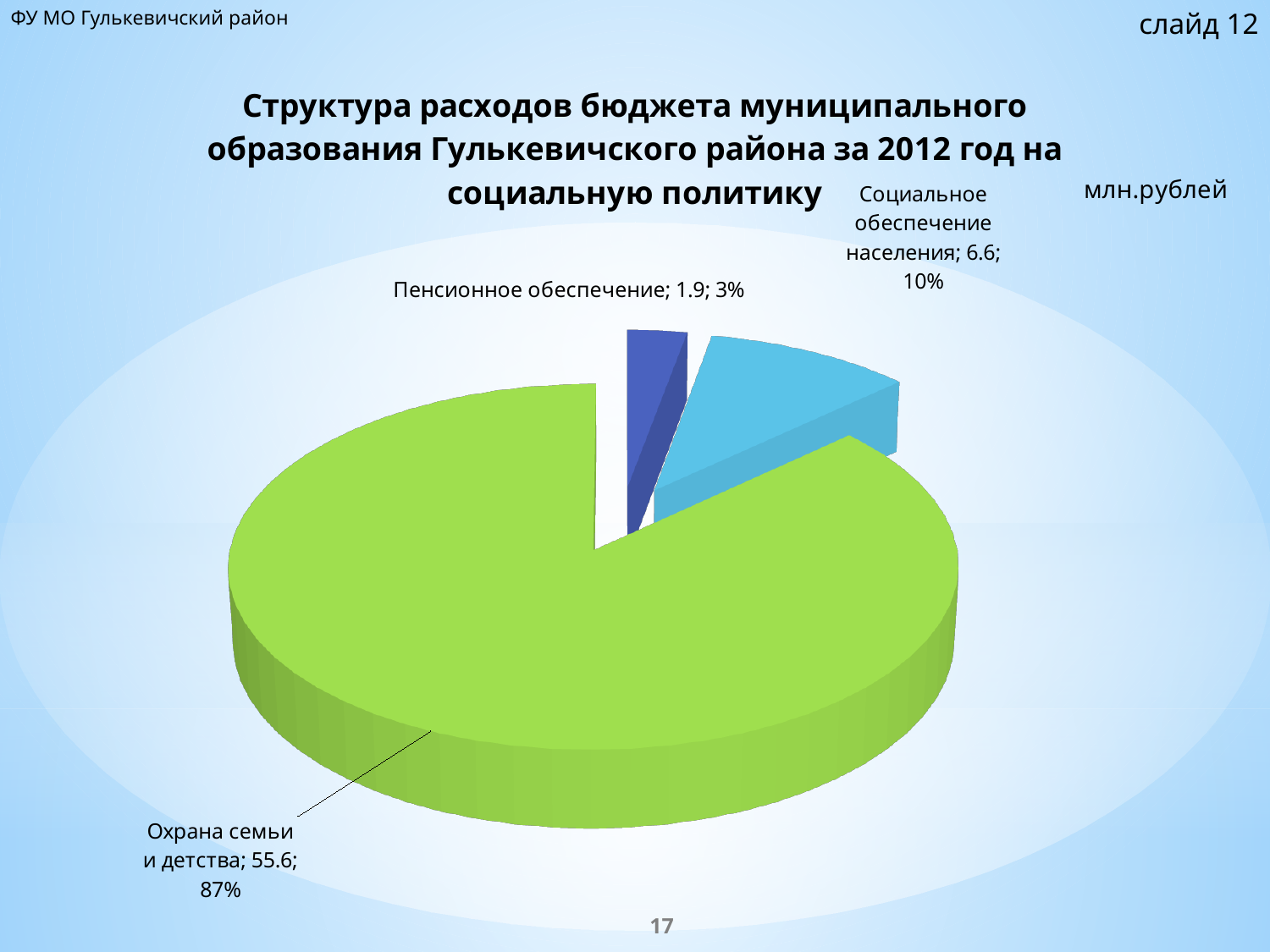
What share of the pie does Пенсионное обеспечение take? 3% What is the value for Охрана семьи и детства? 55.6 In what units are the values on the chart given? млн.рублей What kind of chart is shown on the slide? pie chart What is the value for Социальное обеспечение населения? 6.6 What is the value for Пенсионное обеспечение? 1.9 Which category has the smallest slice? Пенсионное обеспечение How many slices does the pie chart have? 3 What share of the pie does Охрана семьи и детства take? 87% What is the difference between the values for Социальное обеспечение населения and Пенсионное обеспечение? 4.7 What share of the pie does Социальное обеспечение населения take? 10% Which category has the largest slice? Охрана семьи и детства